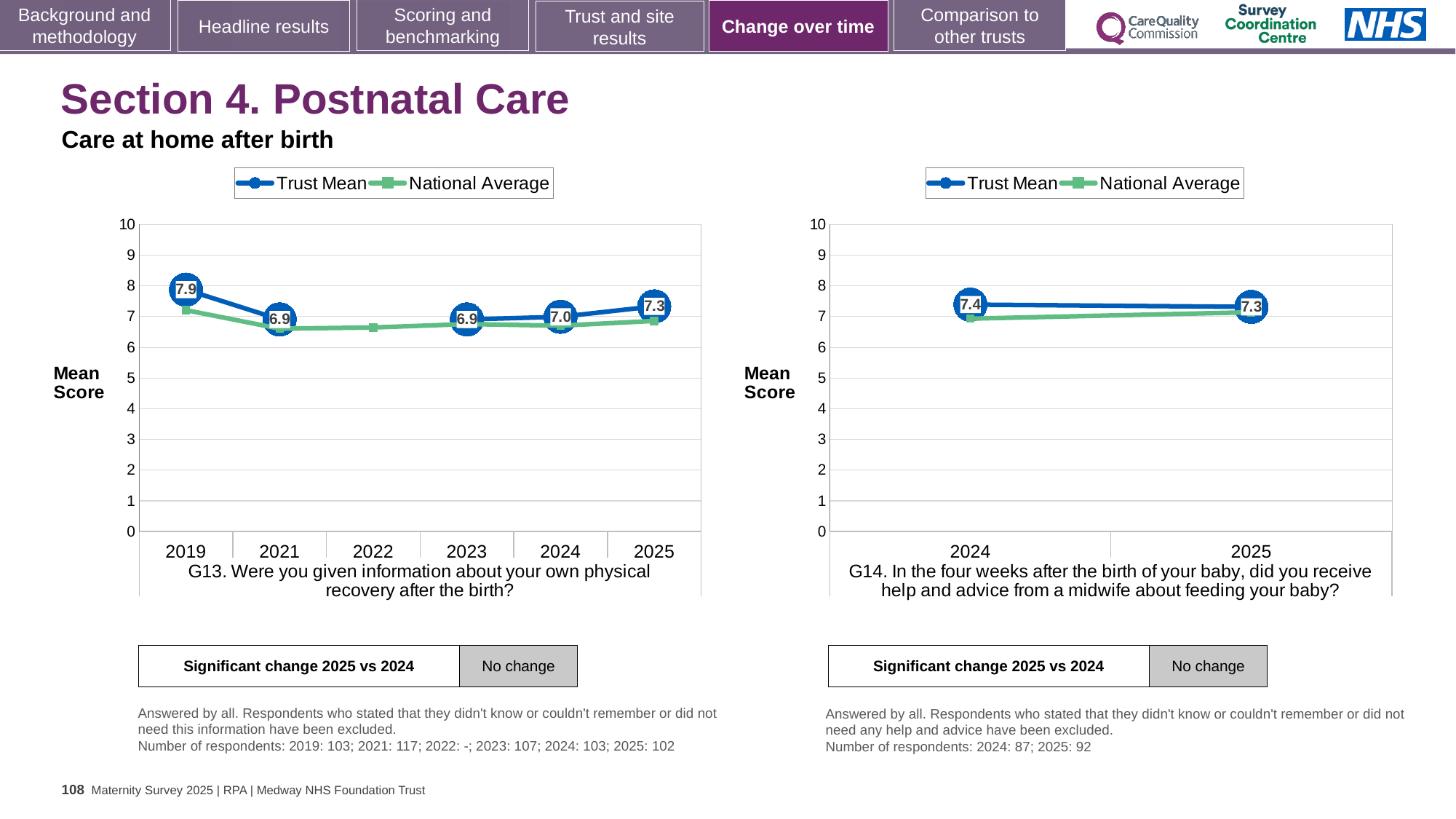
In the G13 chart on the left, what is the Trust Mean for 2025? 7.3 In the G13 chart on the left, which year has the highest Trust Mean? 2019 In the G13 chart on the left, what is the Trust Mean for 2019? 7.9 In the G13 chart on the left, does the Trust Mean rise or fall from 2023 to 2025? Rise How many series does the legend of the G13 chart on the left list? 2 In the G13 chart on the left, is the Trust Mean higher in 2019 or in 2024? 2019 What kind of chart is the G13 chart on the left? Line chart In the G13 chart on the left, is the National Average for 2019 greater or less than 8? less How many years are shown on the x axis of the G14 chart on the right? 2 In the G14 chart on the right, what is the difference between the Trust Mean in 2024 and in 2025? 0.1 In the G14 chart on the right, what is the Trust Mean for 2024? 7.4 In the G13 chart on the left, what is the difference between the Trust Mean in 2019 and in 2025? 0.6